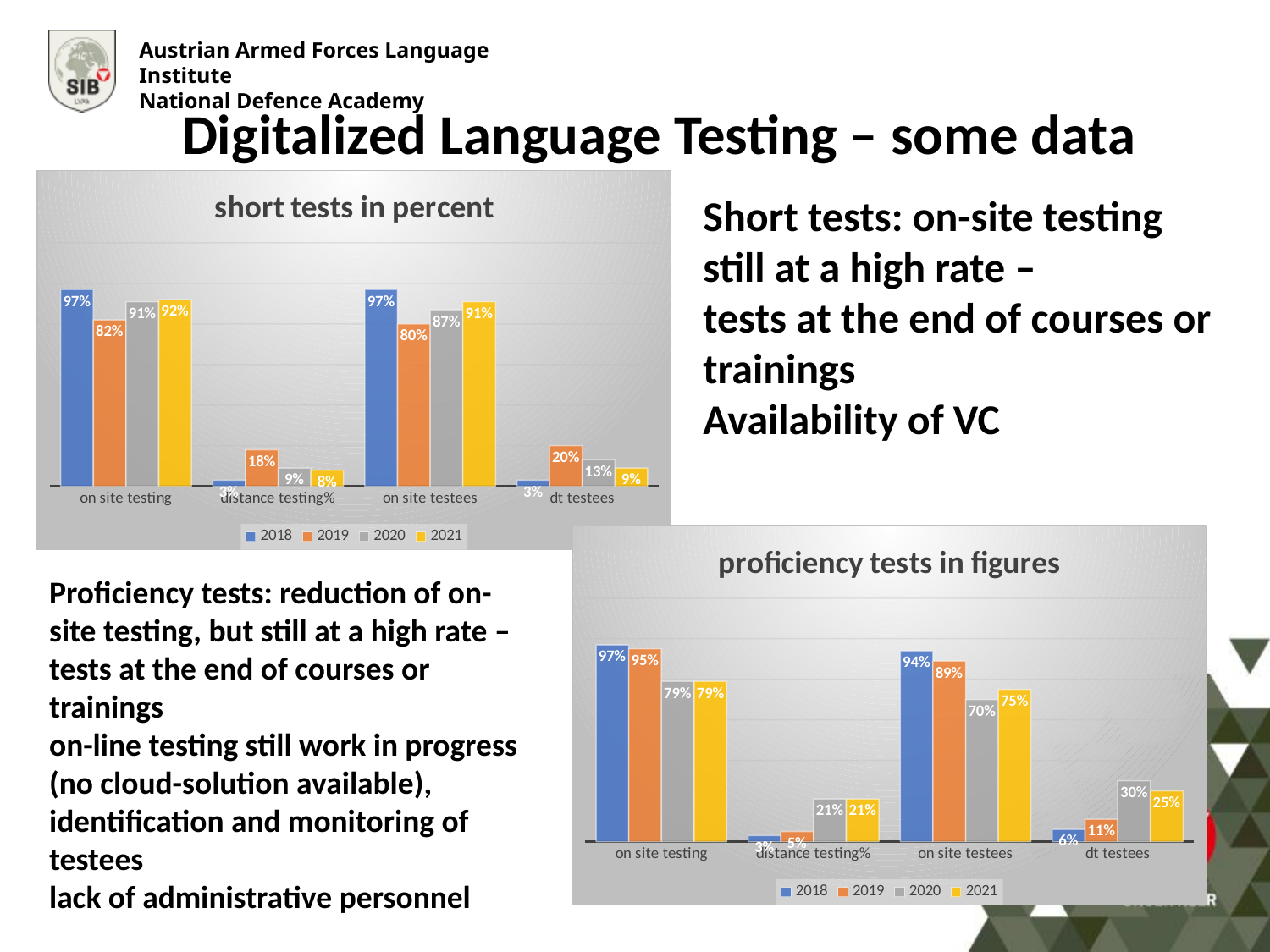
In the 'proficiency tests in figures' chart, what is the difference between the 2020 and 2018 values for dt testees? 24% In the 'proficiency tests in figures' chart, what is the value for on site testees in 2020? 70% In the 'proficiency tests in figures' chart, what is the value for dt testees in 2021? 25% In the 'short tests in percent' chart, what is the difference between the 2018 and 2019 values for on site testees? 17% In the 'short tests in percent' chart, what is the value for dt testees in 2020? 13% In the 'short tests in percent' chart, which year has the highest value for distance testing%? 2019 In the 'short tests in percent' chart, how many series does the legend list? 4 What type of chart is the 'short tests in percent' chart? bar chart In the 'proficiency tests in figures' chart, which year has the lowest value for on site testing? 2020 and 2021 (both 79%) In the 'short tests in percent' chart, what is the value for on site testing in 2019? 82% In the 'proficiency tests in figures' chart, is the 2019 value for on site testees larger or smaller than the 2021 value? larger How many categories are shown on the x axis of the 'proficiency tests in figures' chart? 4